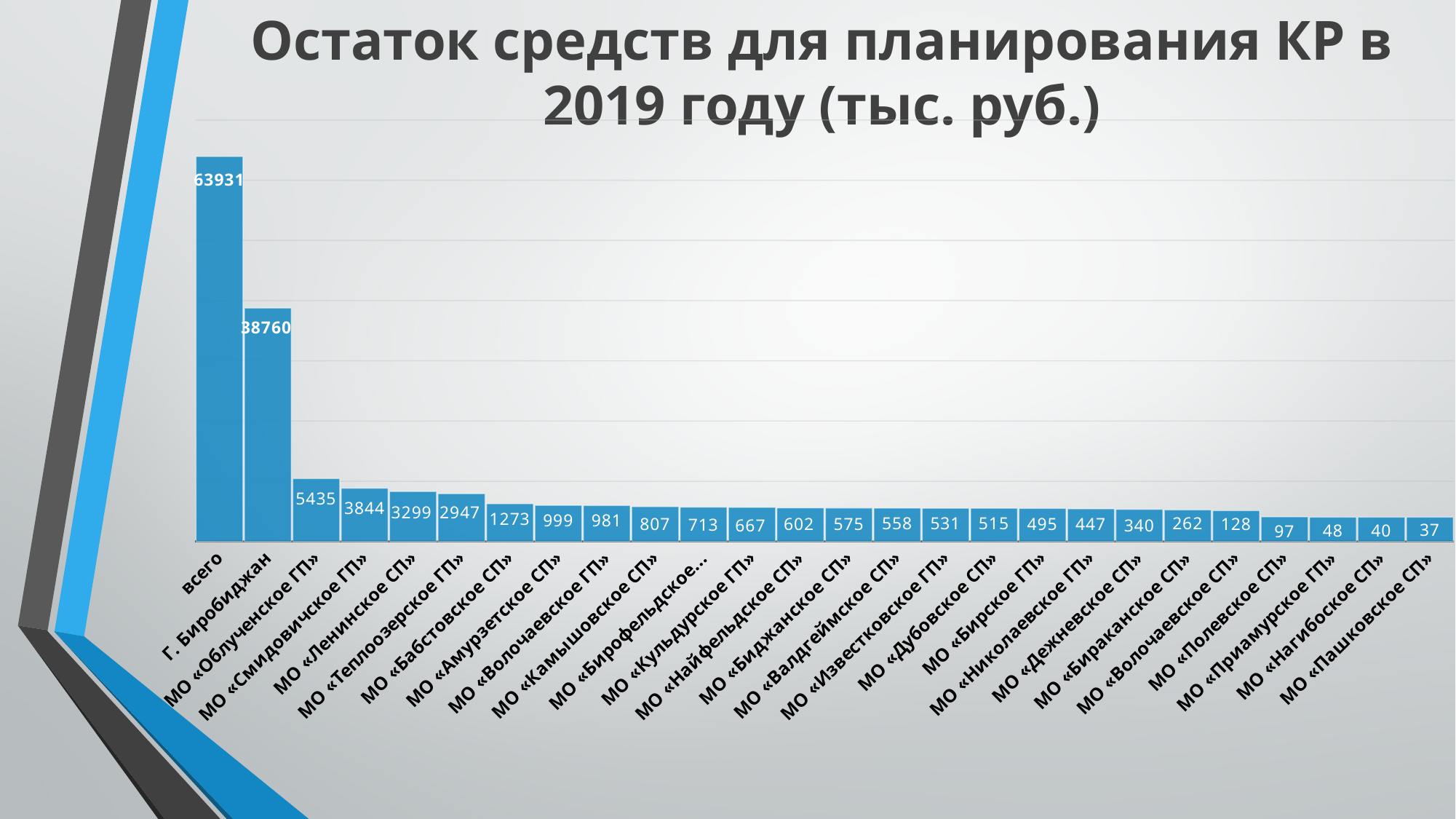
Which category has the lowest value? МО «Пашковское СП» What is the value for МО «Ленинское СП»? 3299 What is the value for МО «Дежневское СП»? 340 What type of chart is shown on the slide? bar chart What is the title of the chart? Остаток средств для планирования КР в 2019 году (тыс. руб.) What is the value for МО «Облученское ГП»? 5435 Which category has the highest value? всего What is the difference between the values for всего and г. Биробиджан? 25171 What is the difference between the values for МО «Облученское ГП» and МО «Смидовичское ГП»? 1591 Which is larger, the value for МО «Бабстовское СП» or МО «Камышовское СП»? МО «Бабстовское СП» What is the value for г. Биробиджан? 38760 How many bars are plotted in the chart? 26